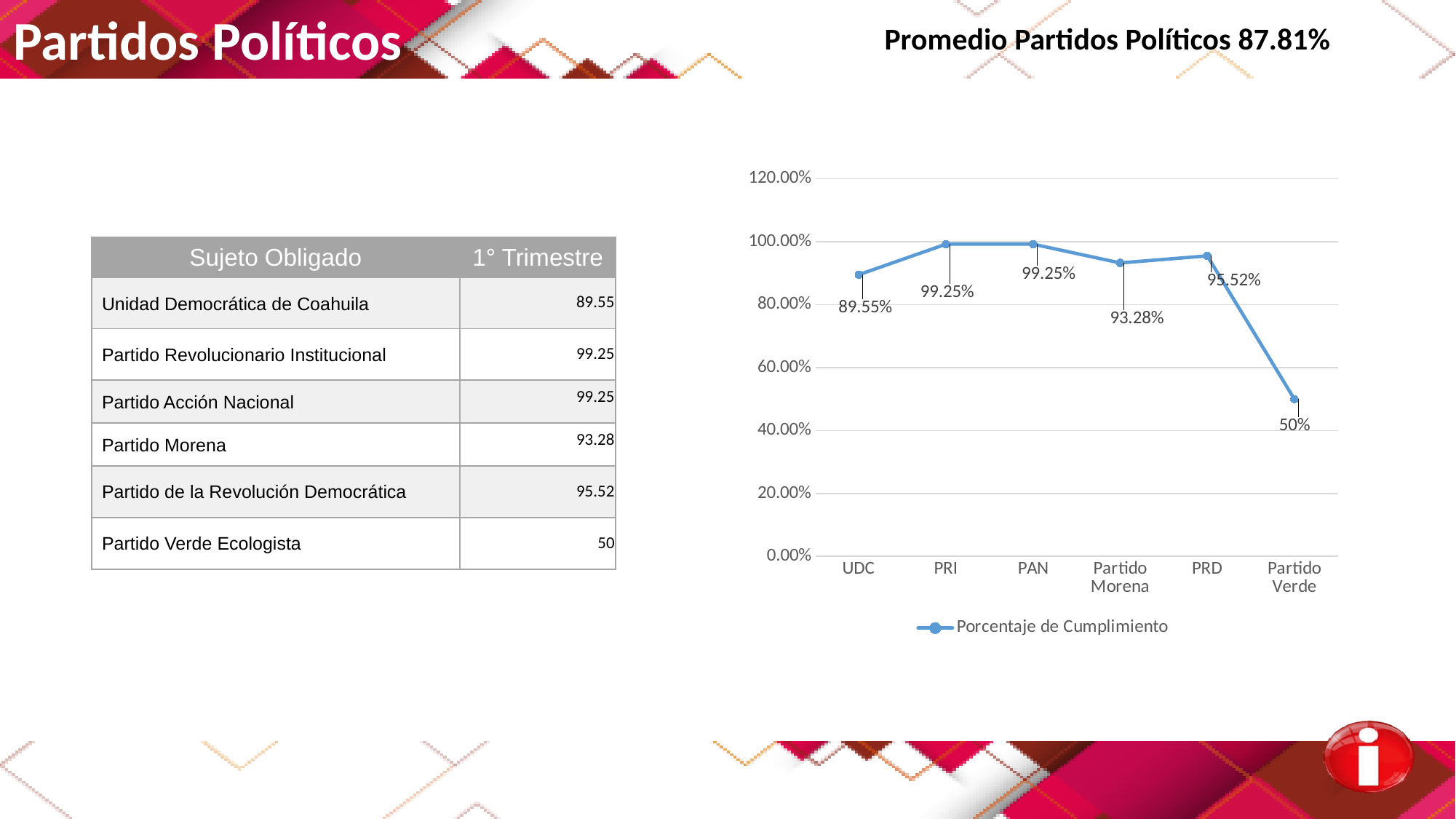
Which is larger, the value for UDC or the value for PRD? PRD What is the value for Partido Morena in the chart? 93.28% What is the name of the series shown in the chart legend? Porcentaje de Cumplimiento How many categories are plotted on the x axis of the chart? 6 Is the value for Partido Morena greater or less than 80.00%? greater How many series does the chart legend list? 1 Which category has the lowest value in the chart? Partido Verde What is the difference between the values for PRI and Partido Verde? 49.25% What is the difference between the values for PRD and Partido Morena? 2.24% What is the value for UDC in the chart? 89.55% What is the value for Partido Verde in the chart? 50% What kind of chart is shown on the slide? line chart